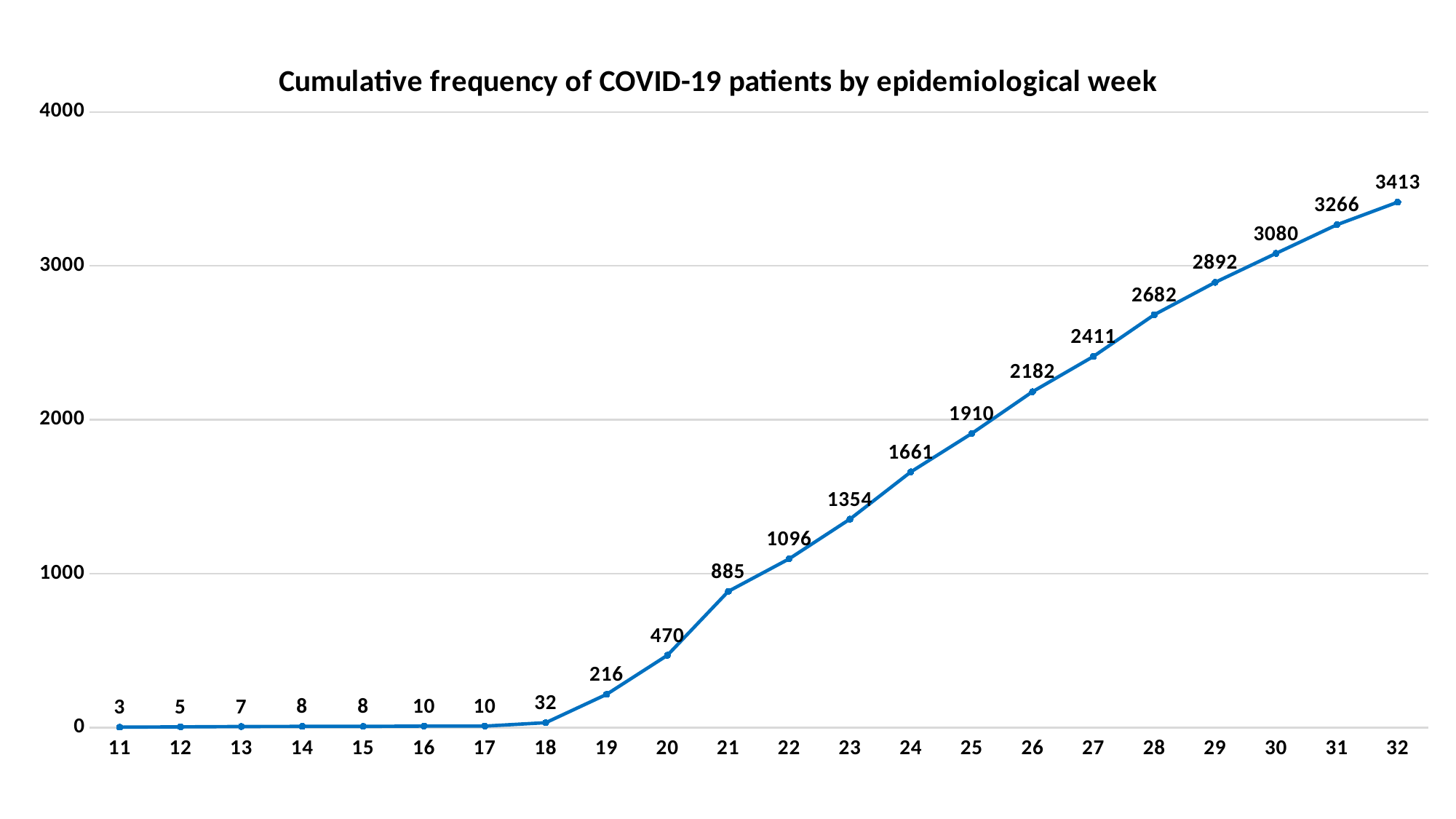
How many epidemiological weeks are plotted on the chart? 22 What is the cumulative frequency of COVID-19 patients at epidemiological week 21? 885 What is the difference in cumulative frequency between week 32 and week 31? 147 Which epidemiological week has the highest cumulative frequency? 32 What is the title of the chart? Cumulative frequency of COVID-19 patients by epidemiological week Which has a larger cumulative frequency, week 20 or week 23? Week 23 Do the values rise or fall from week 11 to week 32? Rise What kind of chart is shown on the slide? Line chart What is the difference in cumulative frequency between week 25 and week 24? 249 Which epidemiological week has the lowest cumulative frequency? 11 What is the cumulative frequency of COVID-19 patients at epidemiological week 28? 2682 What is the cumulative frequency of COVID-19 patients at epidemiological week 18? 32